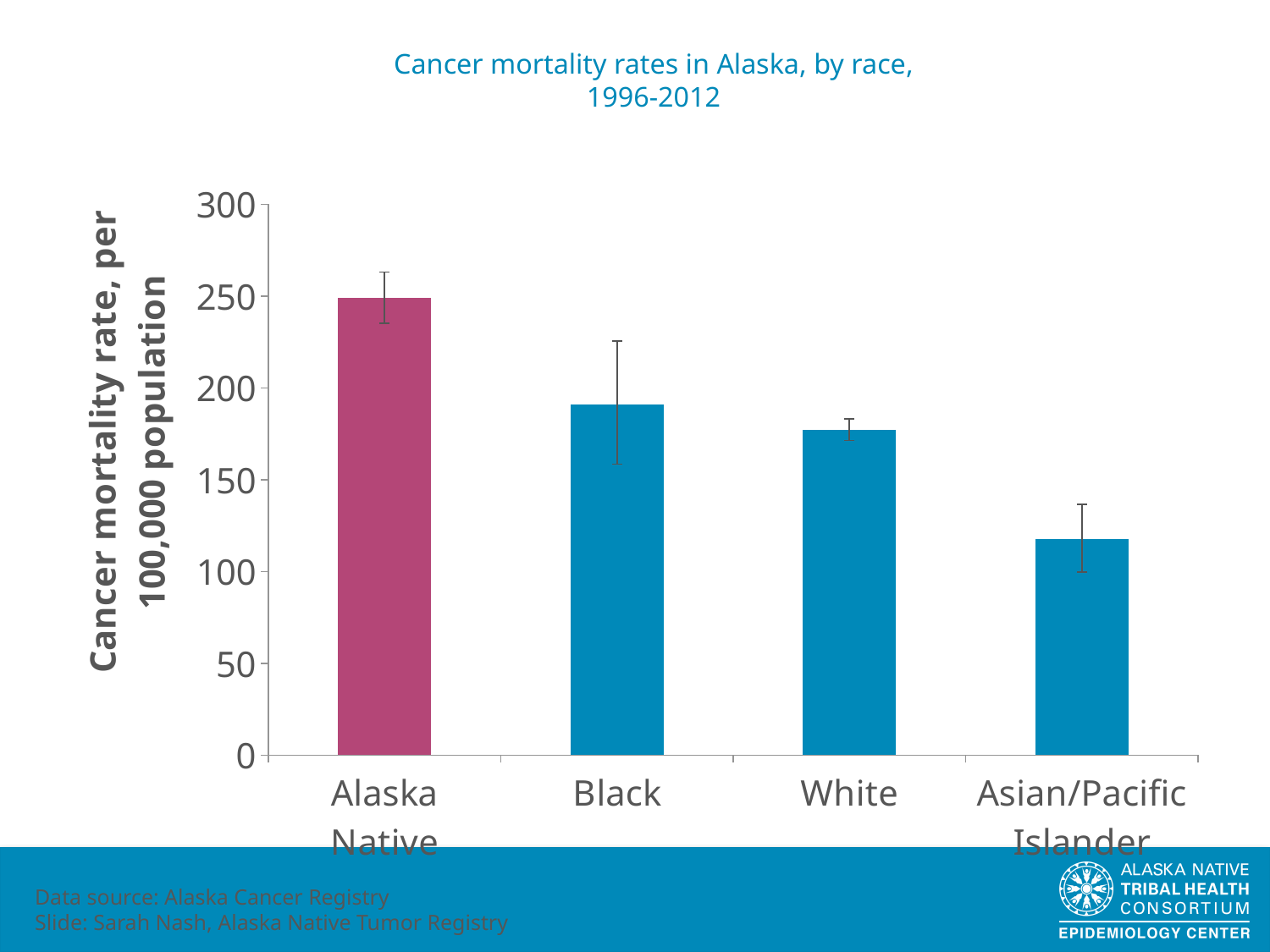
What is the title of the chart? Cancer mortality rates in Alaska, by race, 1996-2012 Is the cancer mortality rate for White greater or less than 200? less Is the cancer mortality rate for Alaska Native greater or less than 200? greater Which racial group has the highest cancer mortality rate? Alaska Native Do the cancer mortality rates rise or fall moving from left to right across the x axis? fall Which has a higher cancer mortality rate, White or Asian/Pacific Islander? White Is the cancer mortality rate for Asian/Pacific Islander greater or less than 150? less How many racial groups are shown on the x axis? 4 Which racial group has the lowest cancer mortality rate? Asian/Pacific Islander What kind of chart is shown on the slide? bar chart Which has a higher cancer mortality rate, Alaska Native or Black? Alaska Native